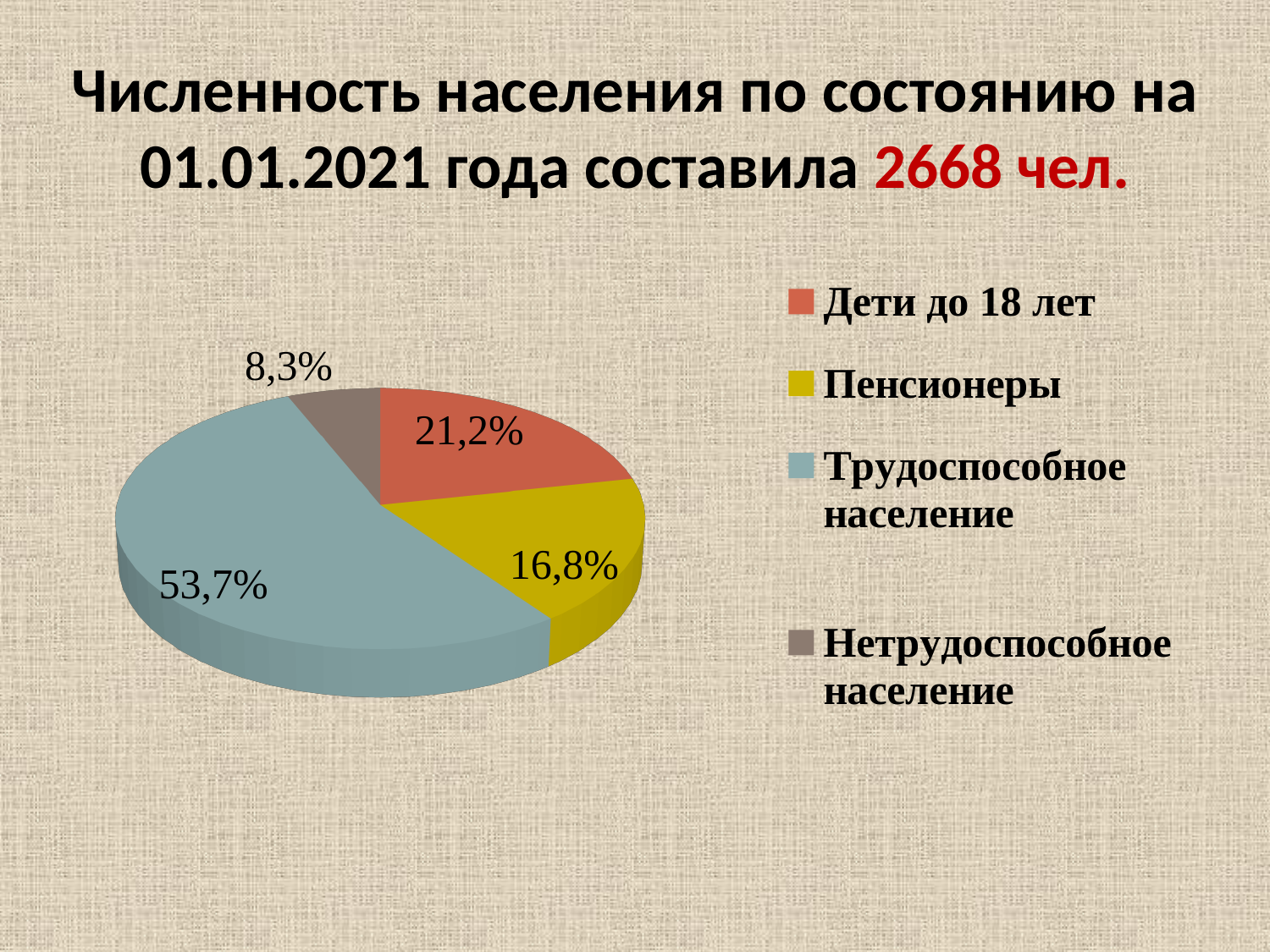
Which is larger: the slice for Пенсионеры or the slice for Нетрудоспособное население? Пенсионеры What share of the pie is labelled for Пенсионеры? 16,8% What kind of chart is shown on the slide? Pie chart What colour is the slice for Трудоспособное население? Light blue What is the difference in percentage points between Дети до 18 лет and Пенсионеры? 4,4 Which category has the largest slice of the pie? Трудоспособное население What share of the pie is labelled for Трудоспособное население? 53,7% How many slices does the pie chart have? 4 Which category has the smallest slice of the pie? Нетрудоспособное население What total population figure is stated in the slide title? 2668 чел. What share of the pie is labelled for Нетрудоспособное население? 8,3% What share of the pie is labelled for Дети до 18 лет? 21,2%